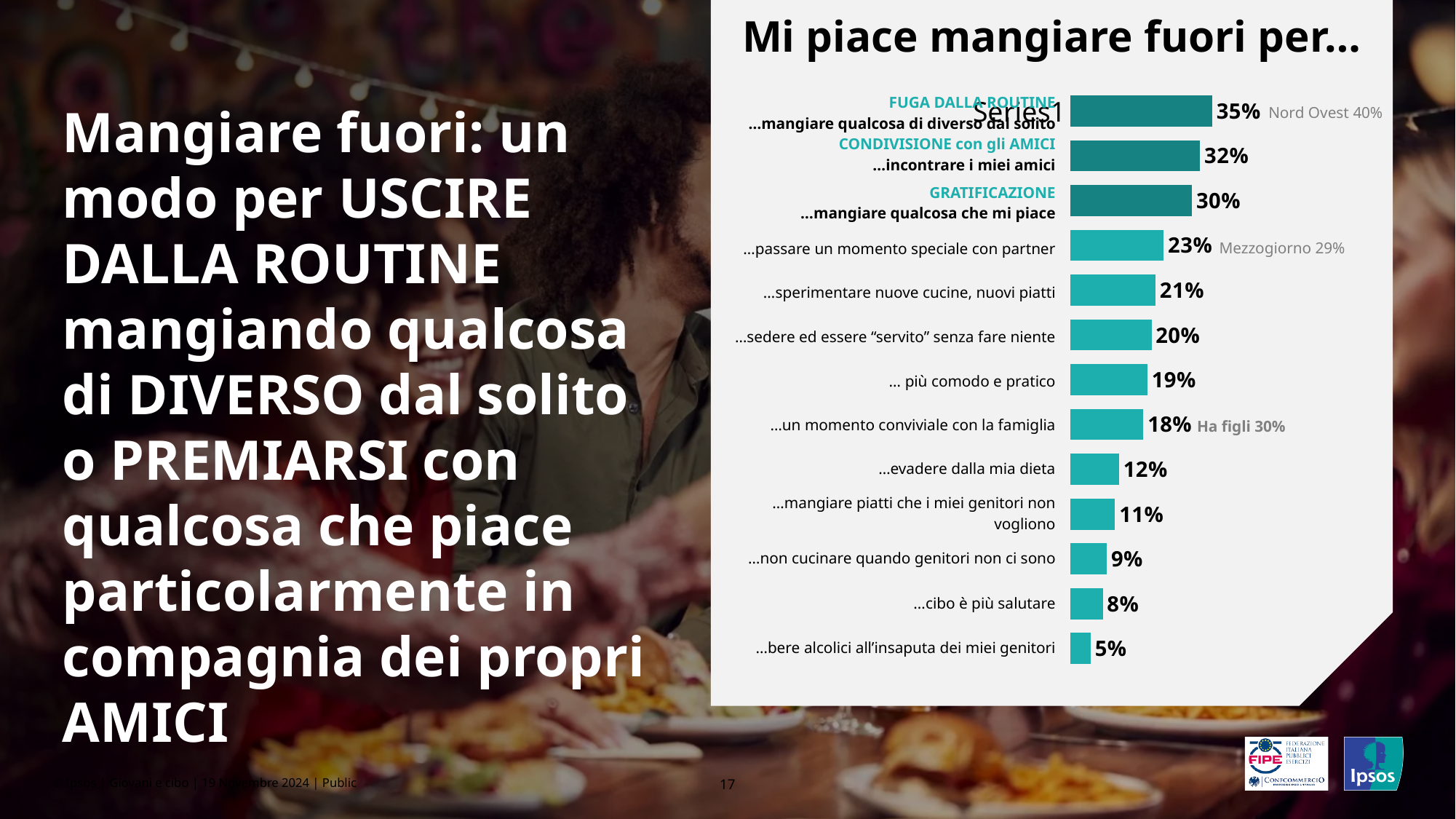
Which category has the lowest value in the chart? ...bere alcolici all'insaputa dei miei genitori What percentage is shown for "...sperimentare nuove cucine, nuovi piatti"? 21% What is the difference in percentage points between "...mangiare qualcosa di diverso dal solito" and "...incontrare i miei amici"? 3 percentage points What is the title of the chart? Mi piace mangiare fuori per... Which category has the highest value in the chart? ...mangiare qualcosa di diverso dal solito What percentage is shown for "...mangiare qualcosa di diverso dal solito"? 35% What percentage is shown for "...incontrare i miei amici"? 32% Which is larger: the value for "...evadere dalla mia dieta" or the value for "...un momento conviviale con la famiglia"? ...un momento conviviale con la famiglia What kind of chart is shown on the slide? Bar chart What percentage is shown for "...cibo è più salutare"? 8% Do the values increase or decrease going from the top bar to the bottom bar? Decrease How many categories are shown in the chart? 13